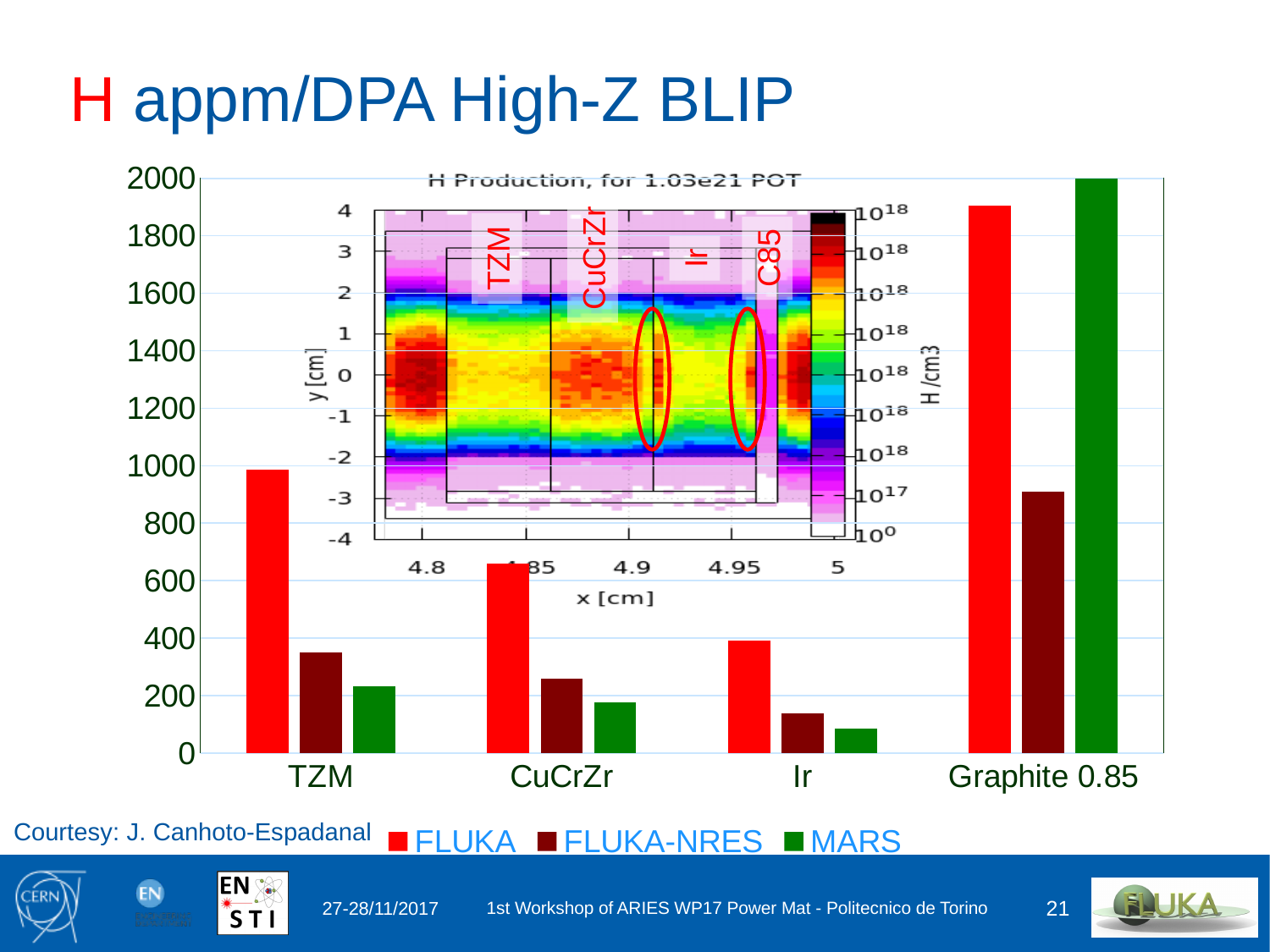
Which material has the lowest MARS value in the bar chart? Ir How many series does the legend of the bar chart list? 3 Which material has the lowest FLUKA value in the bar chart? Ir Which material has the highest FLUKA value in the bar chart? Graphite 0.85 Is the FLUKA-NRES value for Graphite 0.85 greater or less than 800? greater Which is larger, the FLUKA value for TZM or the FLUKA value for CuCrZr? TZM Which colour represents the MARS series in the bar chart legend? green For TZM, which is larger, the FLUKA-NRES value or the MARS value? FLUKA-NRES How many material categories are shown on the x axis of the bar chart? 4 What kind of chart is shown on the slide? bar chart Is the FLUKA value for TZM greater or less than 800? greater Is the MARS value for Ir greater or less than 200? less